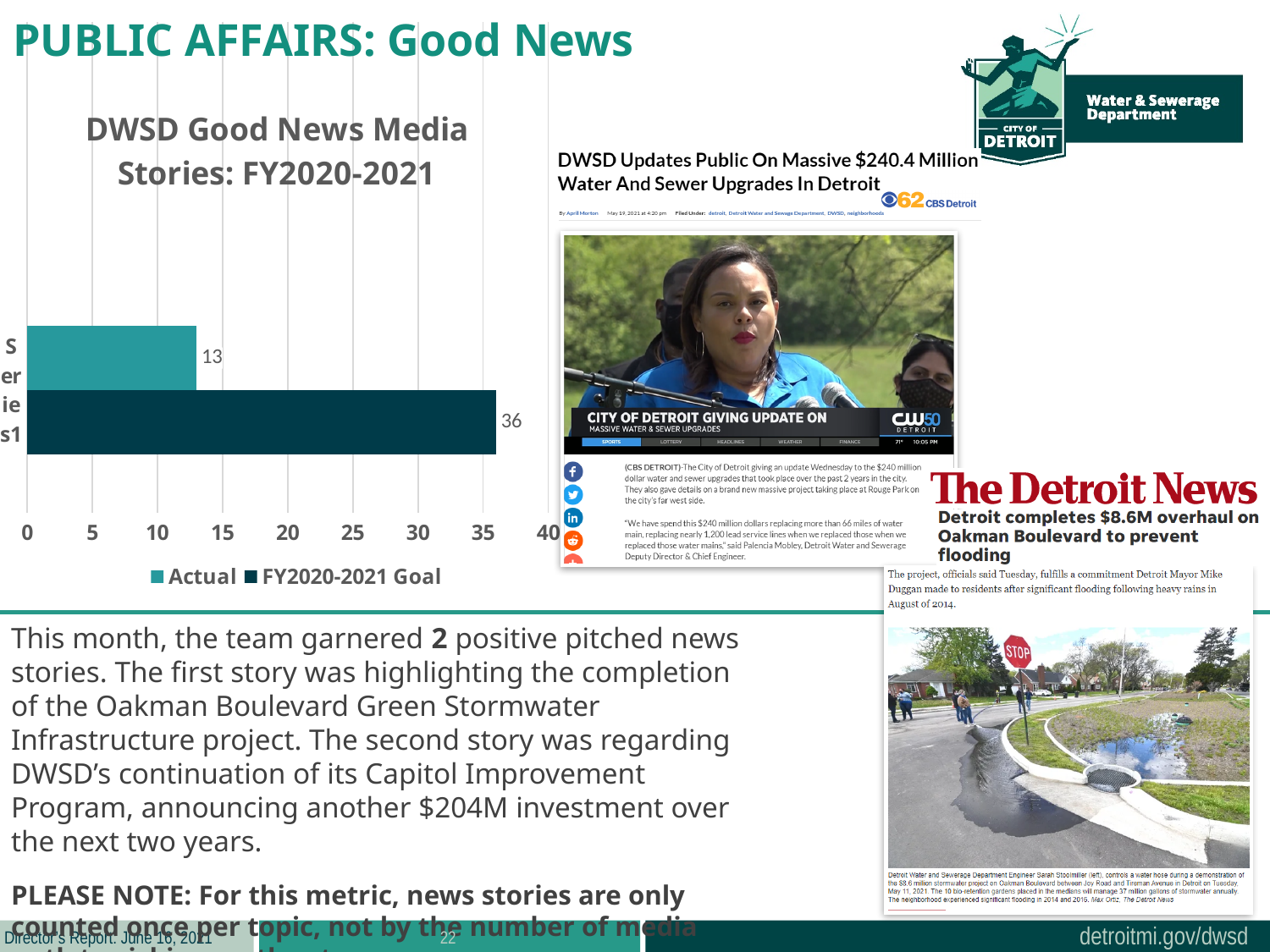
What is the value of the Actual bar in the DWSD Good News Media Stories: FY2020-2021 chart? 13 Which series has the lowest value in the chart? Actual What is the difference between the FY2020-2021 Goal and the Actual value in the chart? 23 Which series has the highest value in the chart? FY2020-2021 Goal Which is larger in the chart, the Actual value or the FY2020-2021 Goal? FY2020-2021 Goal What is the title of the chart on the slide? DWSD Good News Media Stories: FY2020-2021 What is the highest value shown on the x axis of the chart? 40 What is the value of the FY2020-2021 Goal bar in the chart? 36 How many series does the legend of the chart list? 2 Is the Actual value in the chart greater or less than 15? less What kind of chart is shown on the slide? Bar chart Is the FY2020-2021 Goal value in the chart greater or less than 30? greater